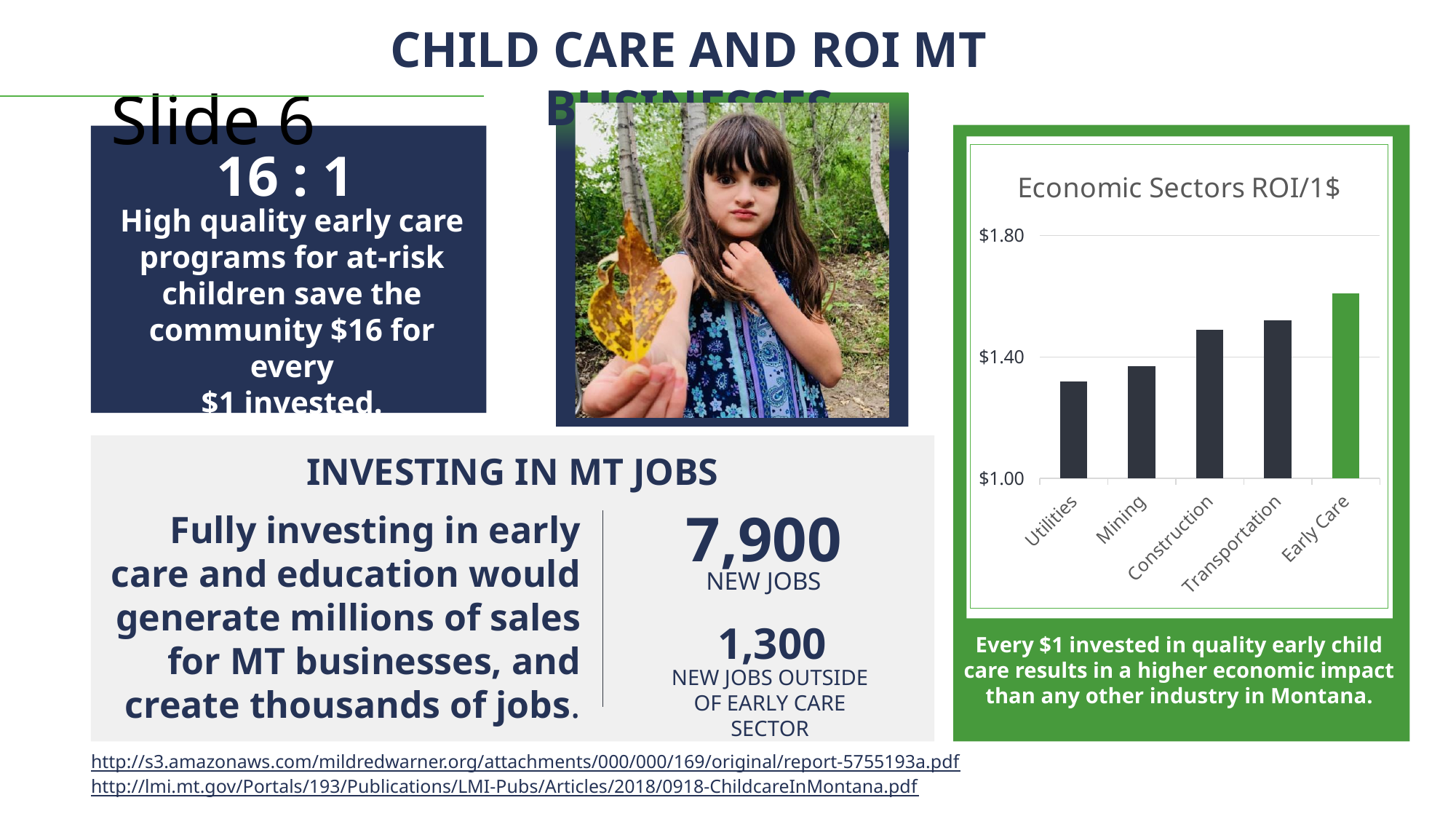
Which has a higher ROI, Early Care or Utilities? Early Care Do the bar values rise or fall from Utilities to Early Care along the x axis? rise What is the title of the chart? Economic Sectors ROI/1$ Which sector has the lowest ROI in the chart? Utilities What type of chart is shown on the slide? bar chart Is the value for Construction greater or less than $1.40? greater Is the value for Early Care greater or less than $1.80? less Which sector has the highest ROI in the chart? Early Care Which has a higher ROI, Construction or Mining? Construction Is the value for Transportation greater or less than $1.40? greater How many economic sectors are plotted in the chart? 5